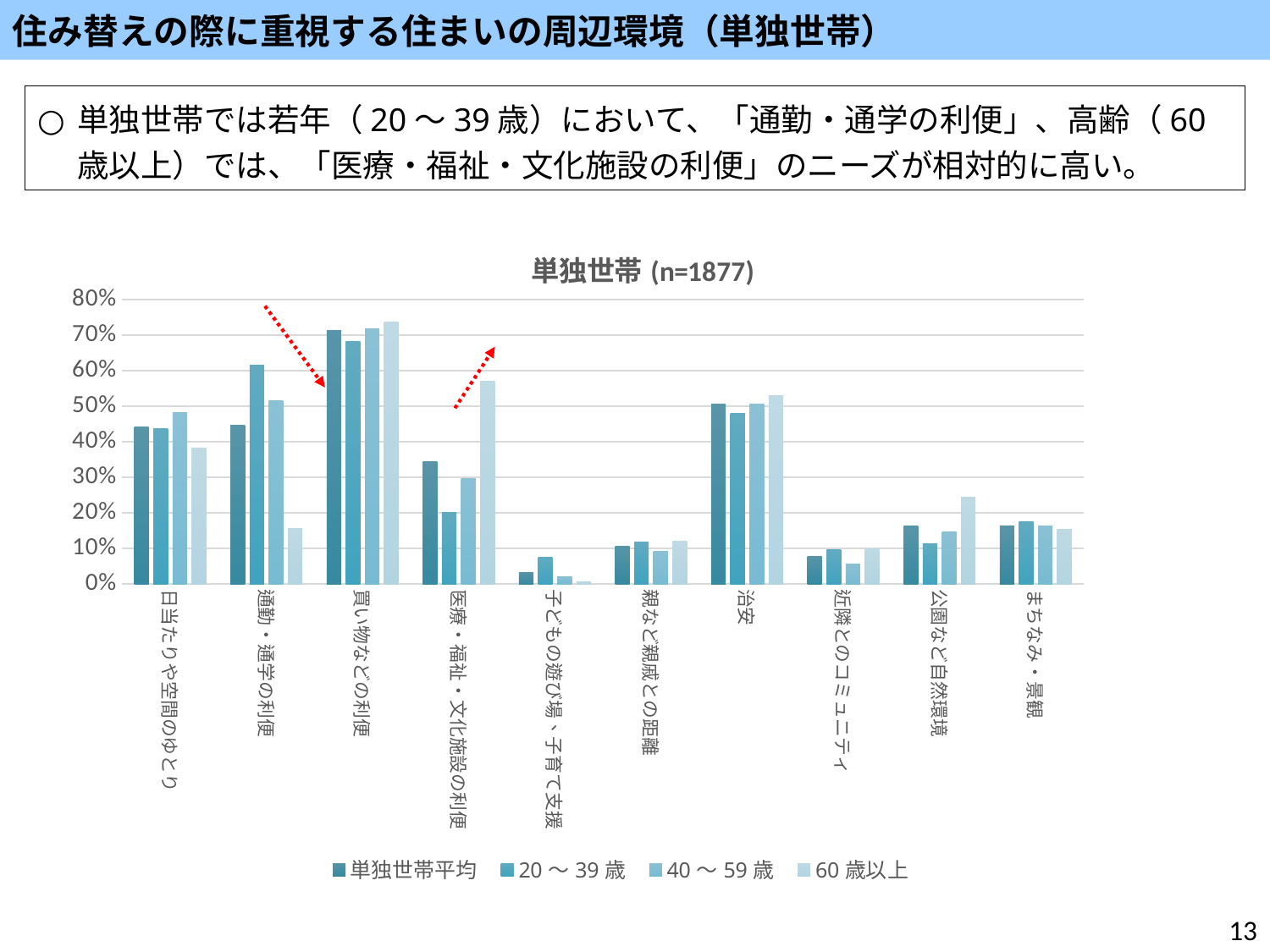
Which category has the highest value in the 単独世帯平均 series? 買い物などの利便 Is the value for 治安 in the 単独世帯平均 series greater or less than 40%? greater How many series does the legend list? 4 Which category has the highest value in the 60歳以上 series? 買い物などの利便 What is the title of the chart? 単独世帯 (n=1877) What kind of chart is shown on the slide? bar chart How many categories are shown on the x axis? 10 Is the value for 医療・福祉・文化施設の利便 in the 60歳以上 series greater or less than 50%? greater For 公園など自然環境, which series has the larger value: 20～39歳 or 60歳以上? 60歳以上 Is the value for 通勤・通学の利便 in the 60歳以上 series greater or less than 20%? less Which category has the lowest value in the 単独世帯平均 series? 子どもの遊び場、子育て支援